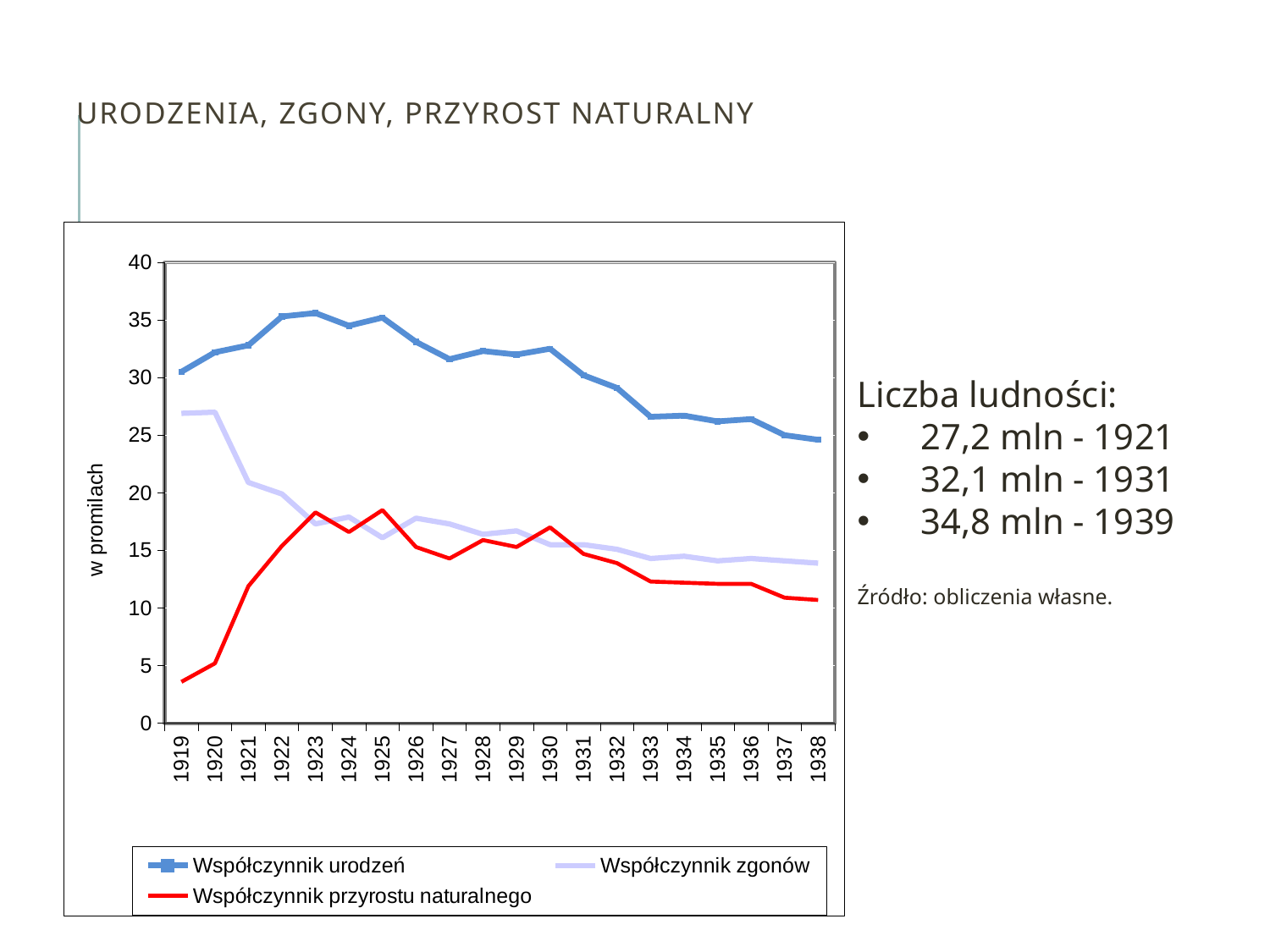
Is the value of Współczynnik zgonów in 1938 greater or less than 15? less Which series is drawn in red on the chart? Współczynnik przyrostu naturalnego Is the value of Współczynnik urodzeń in 1933 greater or less than 30? less How many series does the chart's legend list? 3 In which year is Współczynnik przyrostu naturalnego at its lowest? 1919 Is the value of Współczynnik zgonów in 1919 greater or less than 25? greater Does Współczynnik urodzeń rise or fall between 1925 and 1938? fall In 1919, which is larger: Współczynnik urodzeń or Współczynnik zgonów? Współczynnik urodzeń What is the label on the vertical axis of the chart? w promilach What kind of chart is shown on the slide? line chart How many years are plotted along the x axis of the chart? 20